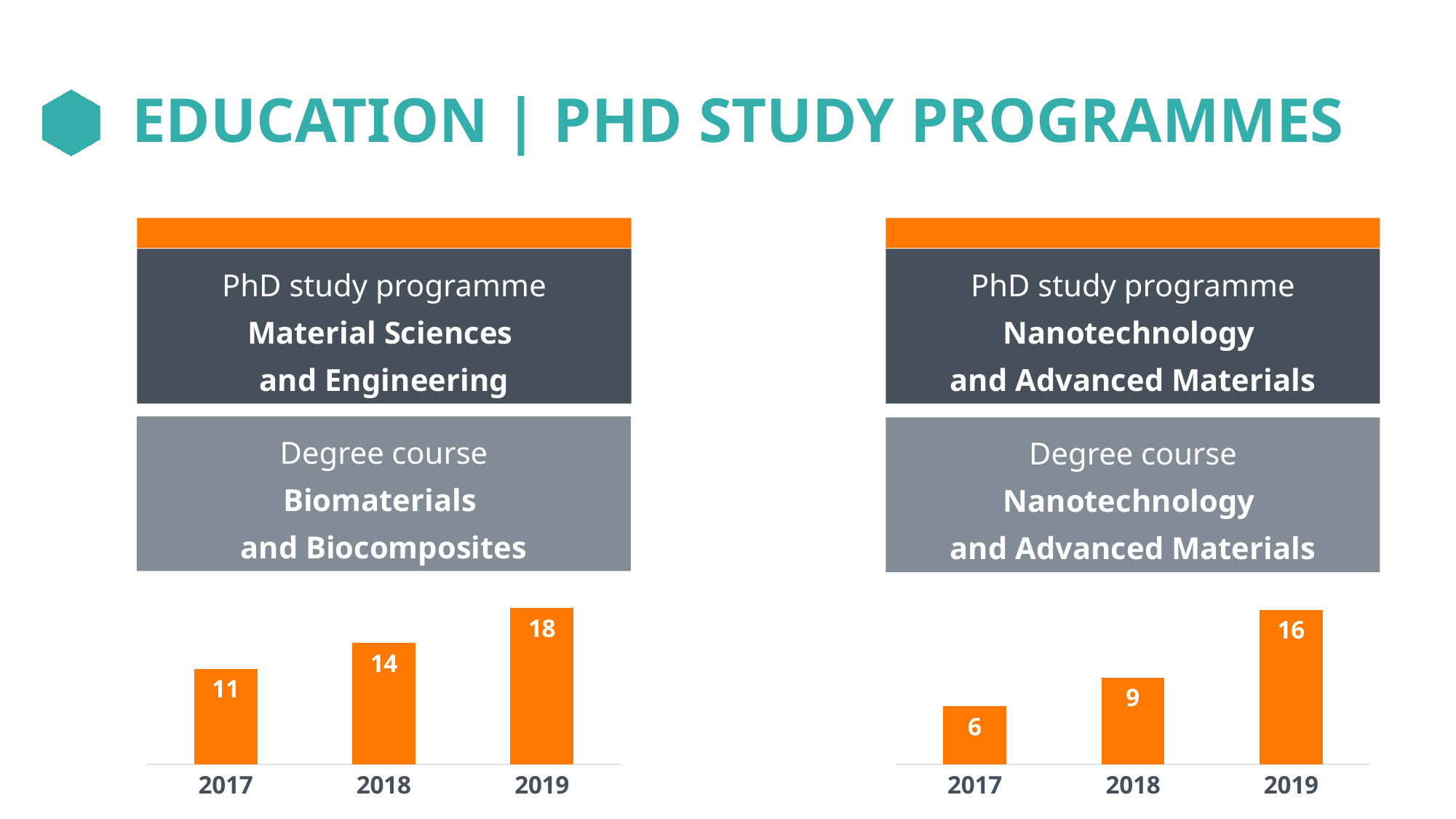
In the right chart (Nanotechnology and Advanced Materials), what is the value for 2018? 9 In the right chart (Nanotechnology and Advanced Materials), what is the difference between the 2019 and 2018 values? 7 How many years are shown on the x axis of the left chart (Material Sciences and Engineering)? 3 In the left chart (Material Sciences and Engineering), what is the value for 2017? 11 In the right chart (Nanotechnology and Advanced Materials), what is the value for 2017? 6 In the left chart (Material Sciences and Engineering), what is the value for 2019? 18 In the right chart (Nanotechnology and Advanced Materials), do the values rise or fall from 2017 to 2019? Rise Which is larger: the 2018 value in the left chart (Material Sciences and Engineering) or the 2019 value in the right chart (Nanotechnology and Advanced Materials)? 2019 value in the right chart What type of chart is used in the right chart (Nanotechnology and Advanced Materials)? Bar chart In the left chart (Material Sciences and Engineering), which year has the highest value? 2019 In the left chart (Material Sciences and Engineering), what is the difference between the 2019 and 2017 values? 7 In the right chart (Nanotechnology and Advanced Materials), which year has the lowest value? 2017